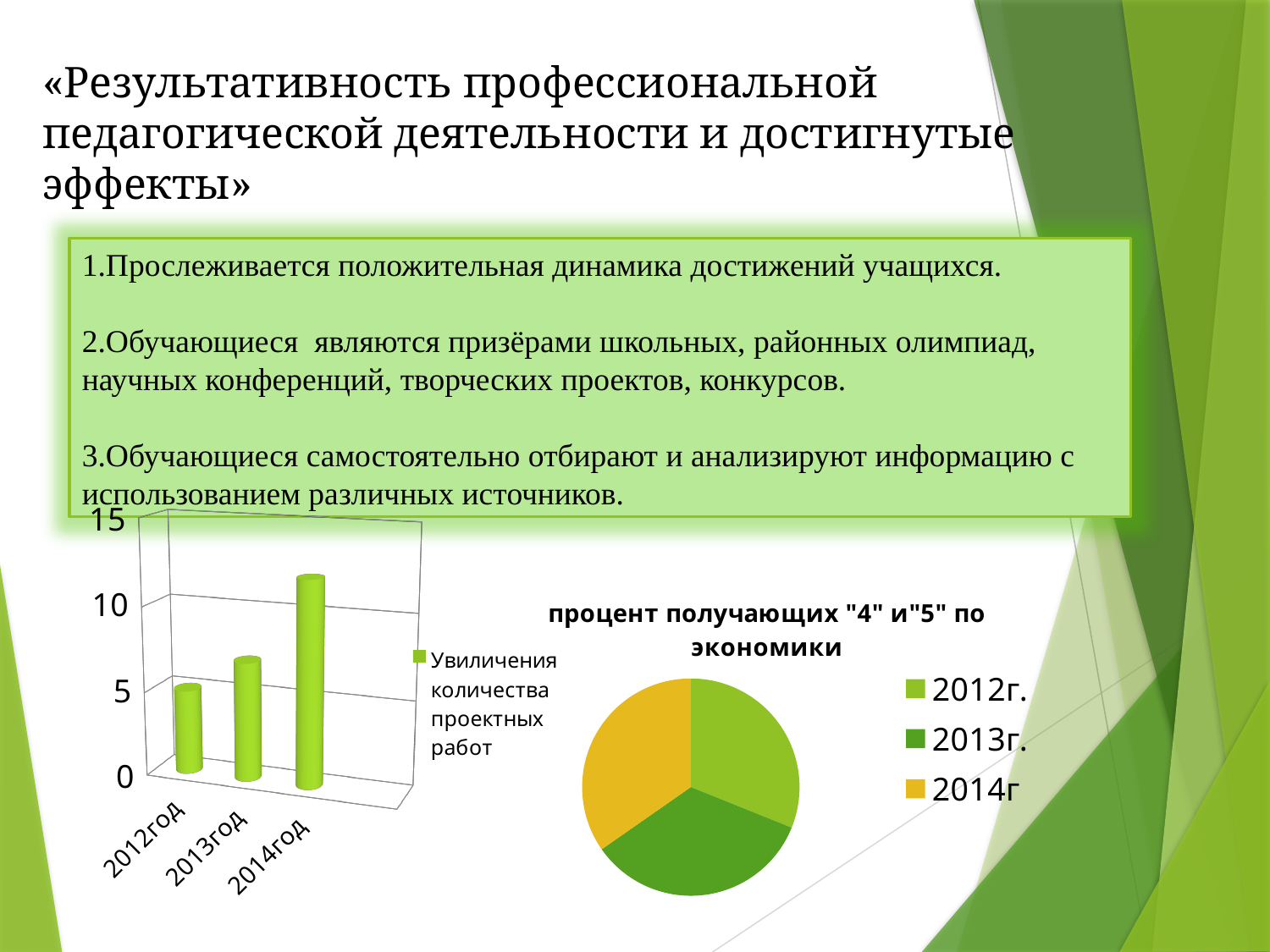
In the bar chart on the left, how many series does the legend list? 1 In the bar chart on the left, is the value for 2012год greater or less than 10? less In the pie chart «процент получающих "4" и"5" по экономики», how many entries does the legend list? 3 In the bar chart on the left, which category has the lowest bar? 2012год In the bar chart on the left, which category has the highest bar? 2014год What kind of chart is the chart titled «процент получающих "4" и"5" по экономики»? pie chart In the bar chart on the left, is the value for 2014год greater or less than 10? greater In the bar chart on the left, do the values rise or fall from 2012год to 2014год? rise In the bar chart on the left, how many categories are shown on the x axis? 3 In the bar chart on the left, which is larger: the value for 2014год or the value for 2012год? 2014год What is the title of the pie chart on the right of the slide? процент получающих "4" и"5" по экономики What kind of chart is the chart on the left of the slide? bar chart